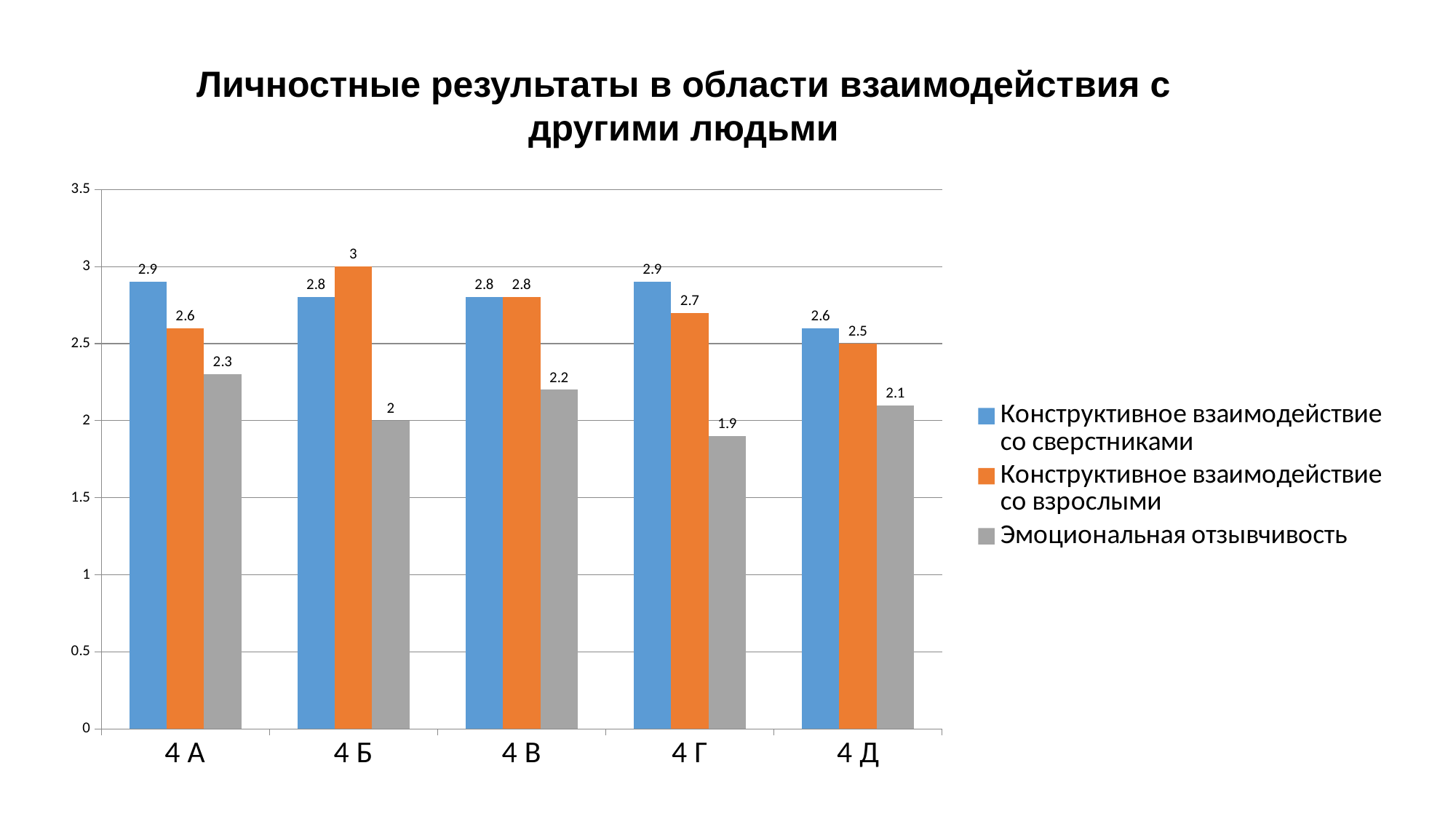
How many classes are shown on the x axis? 5 What is the value of 'Конструктивное взаимодействие со взрослыми' for 4 Б? 3 What is the value of 'Конструктивное взаимодействие со сверстниками' for 4 А? 2.9 How many series does the legend list? 3 What is the difference between 'Конструктивное взаимодействие со сверстниками' and 'Эмоциональная отзывчивость' for 4 Б? 0.8 Which class has the lowest value for 'Эмоциональная отзывчивость'? 4 Г What kind of chart is shown on the slide? bar chart Which is larger for 4 Д: 'Конструктивное взаимодействие со сверстниками' or 'Конструктивное взаимодействие со взрослыми'? Конструктивное взаимодействие со сверстниками What is the title of the chart? Личностные результаты в области взаимодействия с другими людьми What is the value of 'Эмоциональная отзывчивость' for 4 Г? 1.9 Is the value of 'Эмоциональная отзывчивость' for 4 А greater or less than 2? greater Which class has the highest value for 'Конструктивное взаимодействие со взрослыми'? 4 Б